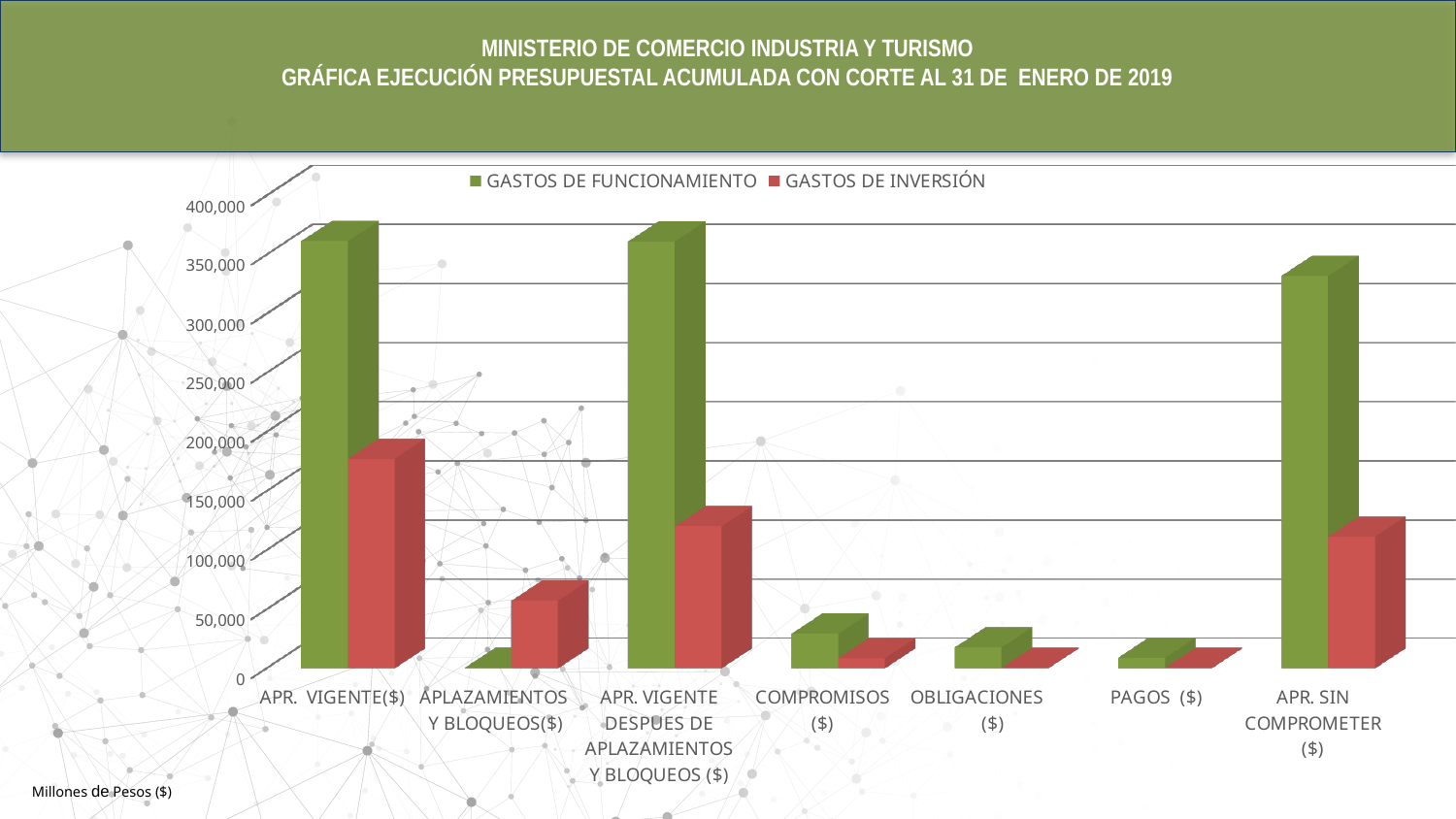
Which series is shown in red? GASTOS DE INVERSIÓN Is the GASTOS DE INVERSIÓN value for APLAZAMIENTOS Y BLOQUEOS($) greater or less than 100,000? less For APLAZAMIENTOS Y BLOQUEOS($), which series has the larger value, GASTOS DE FUNCIONAMIENTO or GASTOS DE INVERSIÓN? GASTOS DE INVERSIÓN Which category has the highest GASTOS DE INVERSIÓN value? APR. VIGENTE($) How many series does the legend list? 2 What unit is indicated at the bottom left of the chart? Millones de Pesos ($) Which category has the lowest GASTOS DE FUNCIONAMIENTO value? APLAZAMIENTOS Y BLOQUEOS($) What kind of chart is shown on the slide? Bar chart Is the GASTOS DE FUNCIONAMIENTO value for COMPROMISOS ($) greater or less than 50,000? less How many categories are shown along the x axis? 7 Is the GASTOS DE FUNCIONAMIENTO value for APR. VIGENTE($) greater or less than 300,000? greater